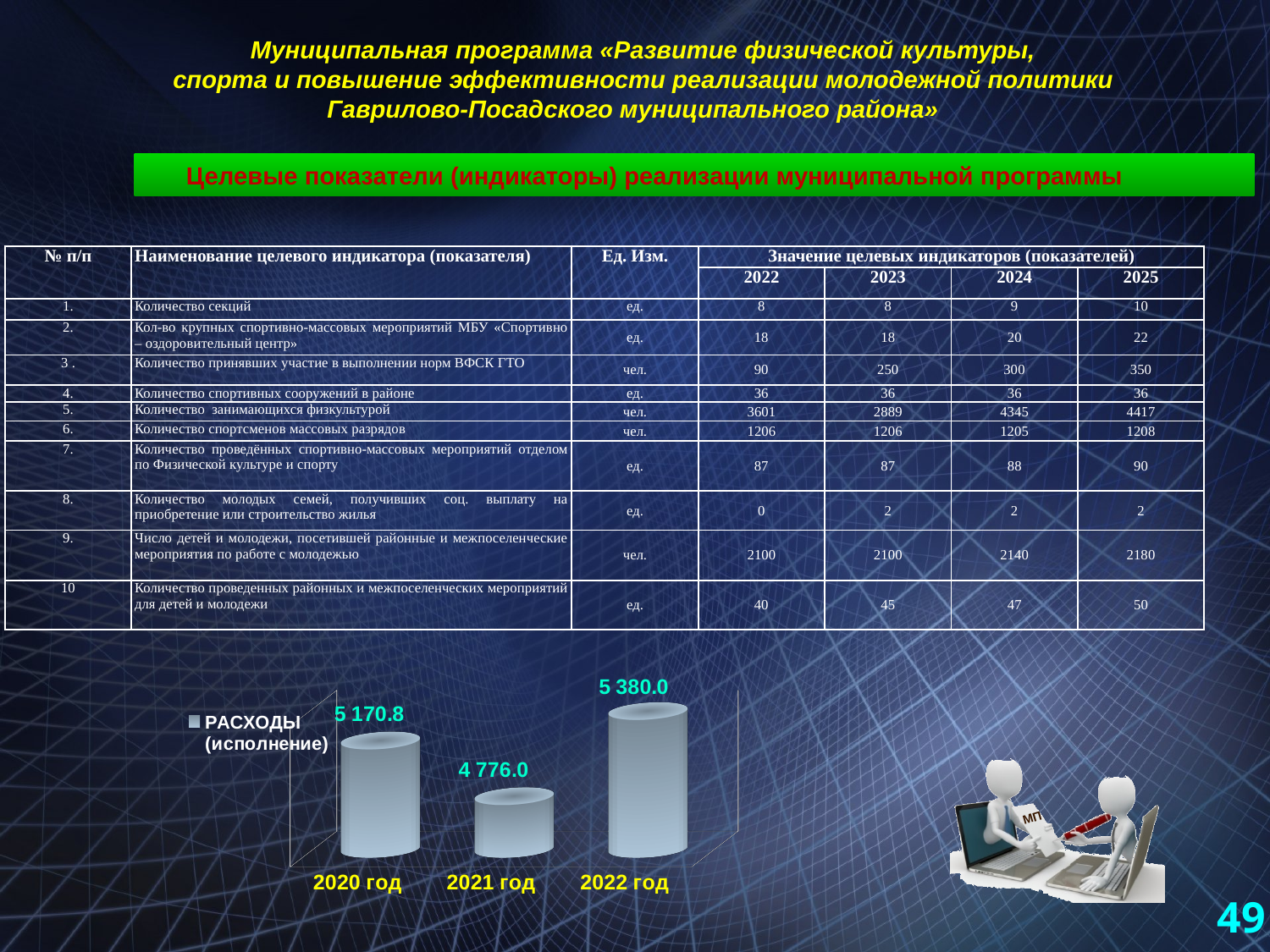
What kind of chart is shown on the slide? bar chart What is the value for 2021 год in the chart? 4 776.0 What is the difference between the values for 2020 год and 2021 год? 394.8 What is the value for 2020 год in the chart? 5 170.8 What is the difference between the values for 2022 год and 2020 год? 209.2 Which year has the highest value in the chart? 2022 год How many years (categories) are shown in the chart? 3 How many series does the chart legend list? 1 Which is larger, the value for 2020 год or the value for 2021 год? 2020 год What is the value for 2022 год in the chart? 5 380.0 Which year has the lowest value in the chart? 2021 год What is the name of the series in the chart legend? РАСХОДЫ (исполнение)